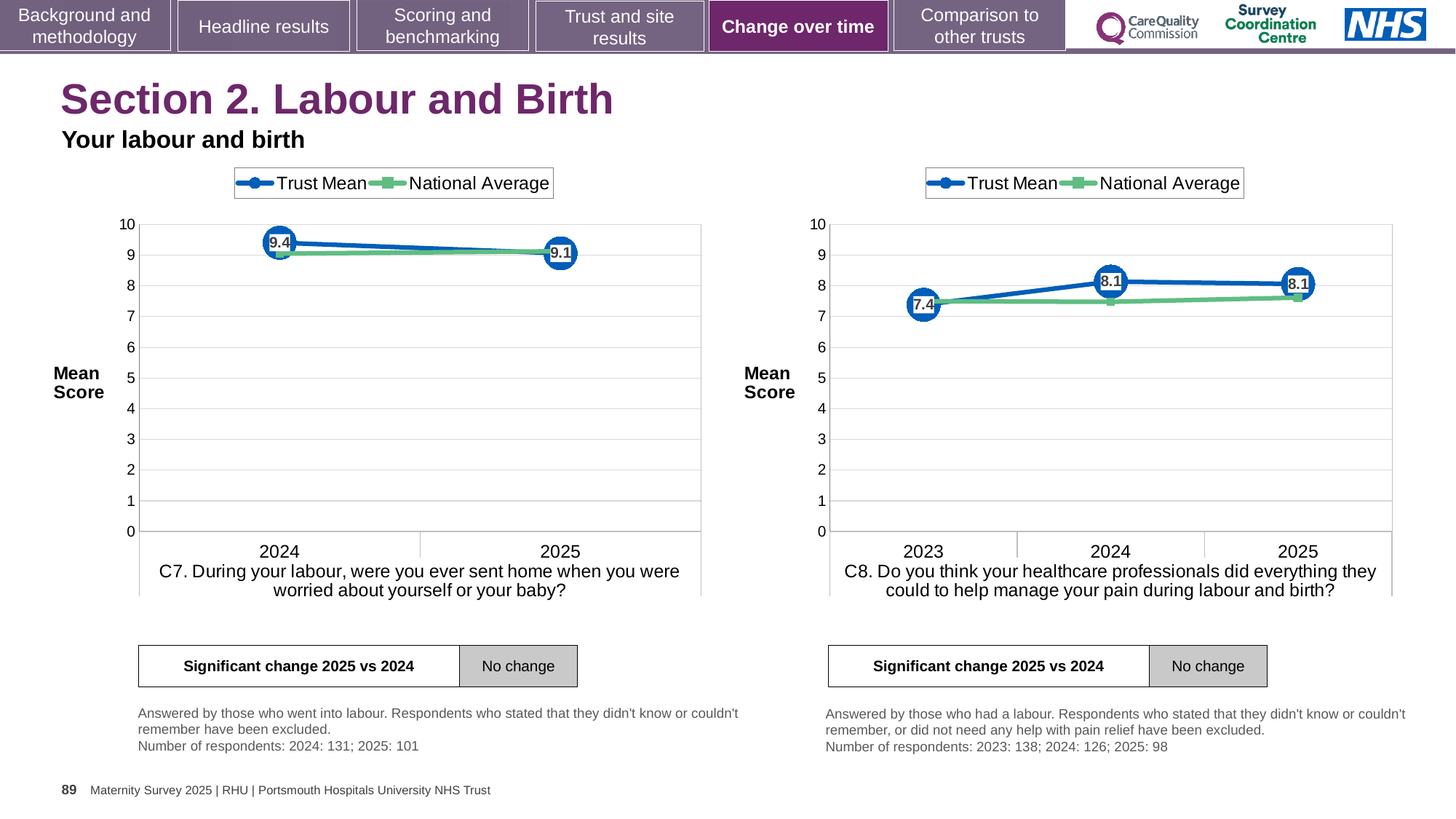
In the C8 chart on the right, which year has the lowest Trust Mean? 2023 In the C7 chart on the left, which year has the higher Trust Mean? 2024 What kind of chart is the C8 chart on the right? Line chart In the C8 chart on the right, is the National Average for 2023 greater or less than 7? greater How many years are plotted on the x axis of the C8 chart on the right? 3 In the C7 chart on the left, by how much did the Trust Mean fall from 2024 to 2025? 0.3 In the C7 chart on the left, what is the Trust Mean for 2025? 9.1 In the C8 chart on the right, is the Trust Mean for 2023 larger or smaller than the Trust Mean for 2025? smaller In the C7 chart on the left, what is the Trust Mean for 2024? 9.4 In the C8 chart on the right, what is the Trust Mean for 2023? 7.4 In the C8 chart on the right, what is the Trust Mean for 2025? 8.1 How many series does the legend of the C7 chart on the left list? 2